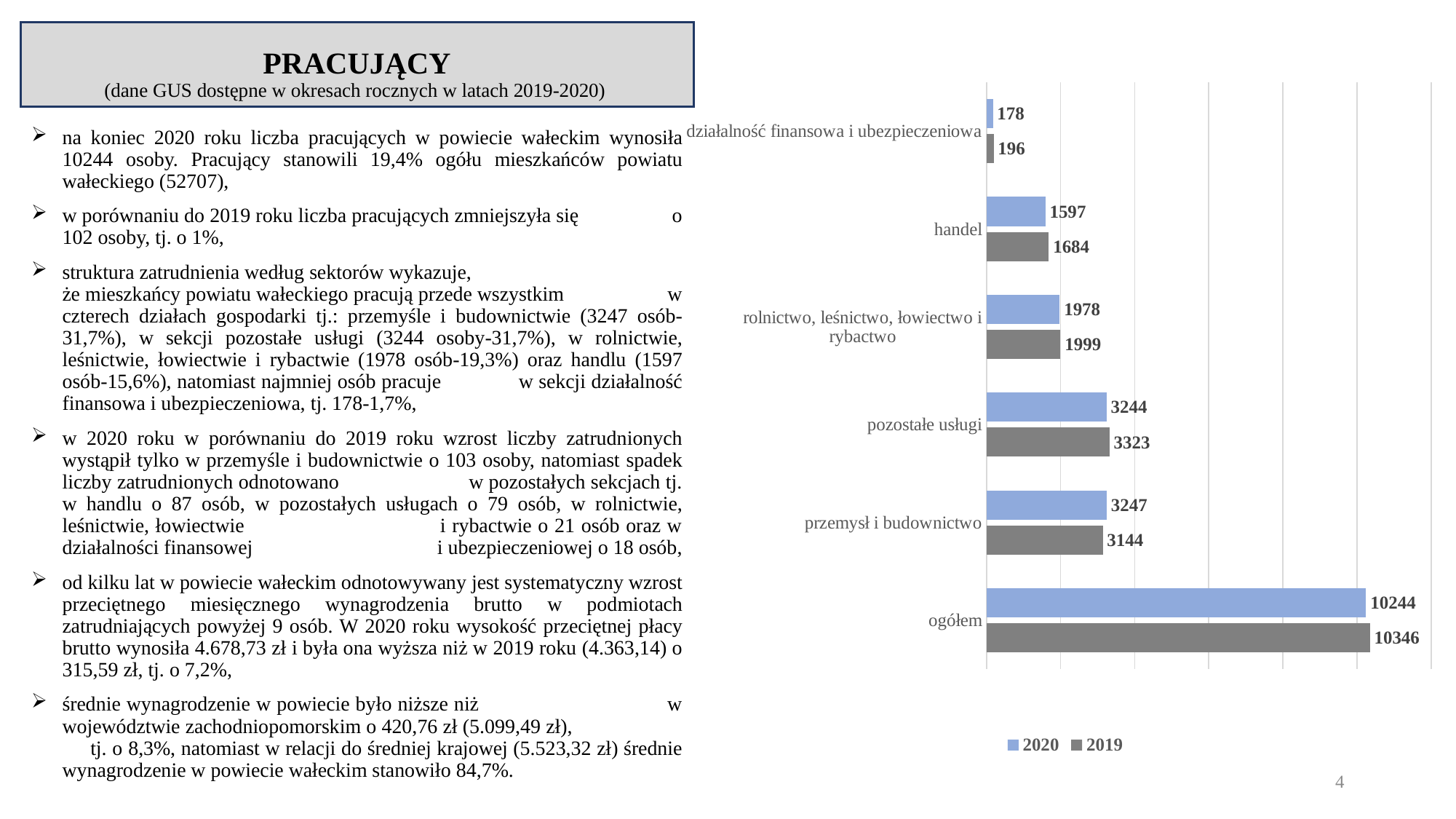
How many series does the chart legend list? 2 Which colour represents the 2019 series in the chart? grey What is the 2019 value for pozostałe usługi? 3323 Excluding ogółem, which category has the highest 2019 value? pozostałe usługi For przemysł i budownictwo, which year has the larger value, 2020 or 2019? 2020 What is the 2019 value for działalność finansowa i ubezpieczeniowa? 196 What is the difference between the 2019 and 2020 values for ogółem? 102 What is the 2020 value for ogółem? 10244 How many categories are shown on the chart? 6 What kind of chart is shown on the slide? bar chart Excluding ogółem, which category has the lowest 2020 value? działalność finansowa i ubezpieczeniowa What is the 2020 value for handel? 1597